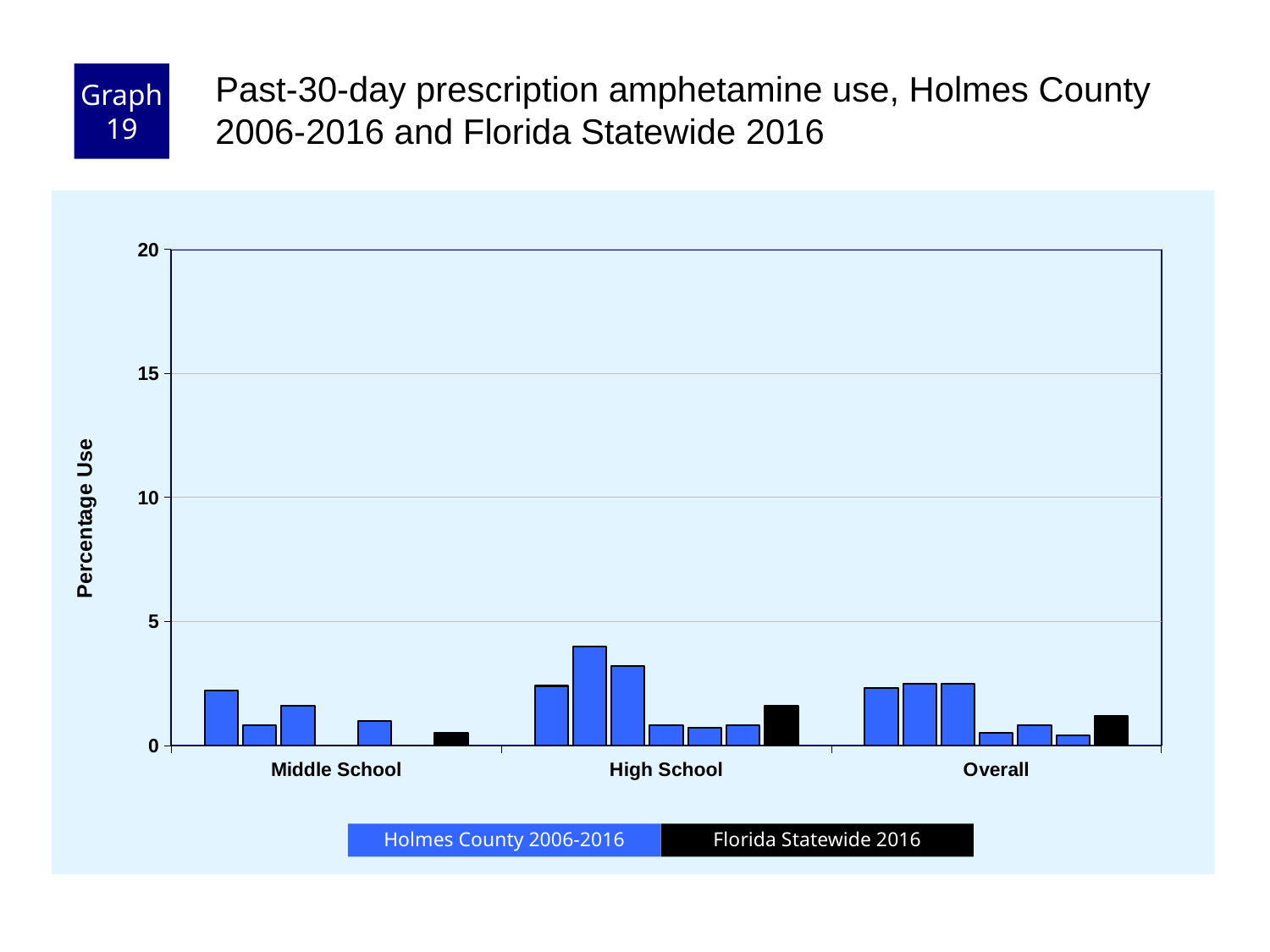
Which is larger: the Florida Statewide 2016 value for Overall or for Middle School? Overall What is the title of the chart? Past-30-day prescription amphetamine use, Holmes County 2006-2016 and Florida Statewide 2016 What kind of chart is shown on the slide? bar chart Which category has the lowest Florida Statewide 2016 value? Middle School Which is larger: the Florida Statewide 2016 value for High School or for Middle School? High School How many series does the legend list? 2 Is the highest Holmes County 2006-2016 bar in the High School category greater or less than 5? less Is the value for Florida Statewide 2016 in the High School category greater or less than 5? less Which category contains the tallest bar on the chart? High School How many categories are shown on the x axis? 3 Is the value for Florida Statewide 2016 in the Overall category greater or less than 5? less What is the label on the y axis? Percentage Use